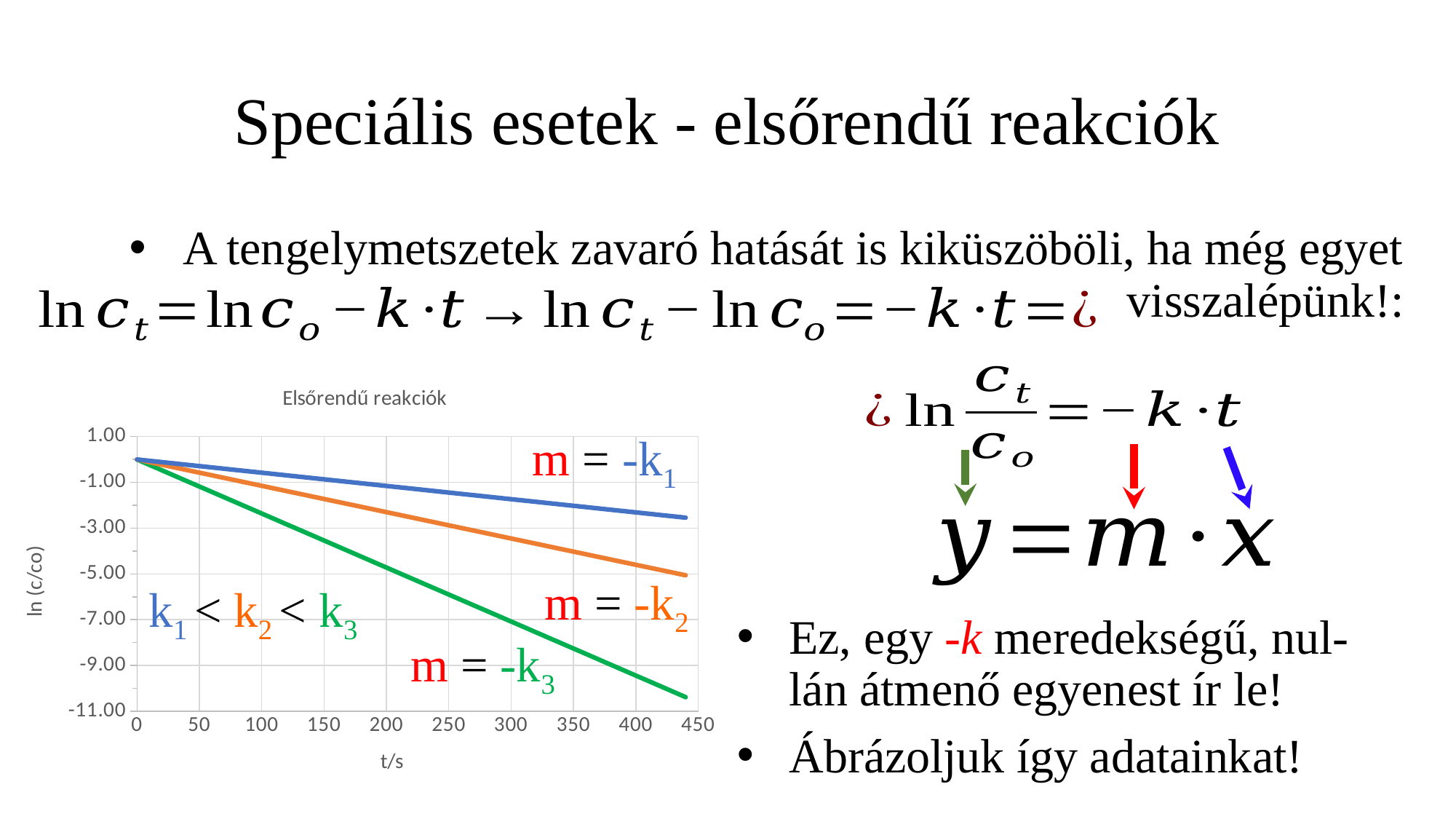
Is the value of the orange line at t/s = 200 greater or less than -3.00? greater Which line has the highest value at t/s = 400? blue What kind of chart is shown on the slide? line chart How many lines are plotted in the chart? 3 Which line has the steepest slope: the blue, the orange or the green one? green What is the title of the chart? Elsőrendű reakciók Is the value of the blue line at t/s = 400 greater or less than -3.00? greater Which line has the lowest value at t/s = 400? green Is the value of the green line at t/s = 300 greater or less than -5.00? less At t/s = 300, is the orange line's value larger or smaller than the green line's value? larger What is the label of the x axis of the chart? t/s Do the plotted lines rise or fall as t/s increases? fall